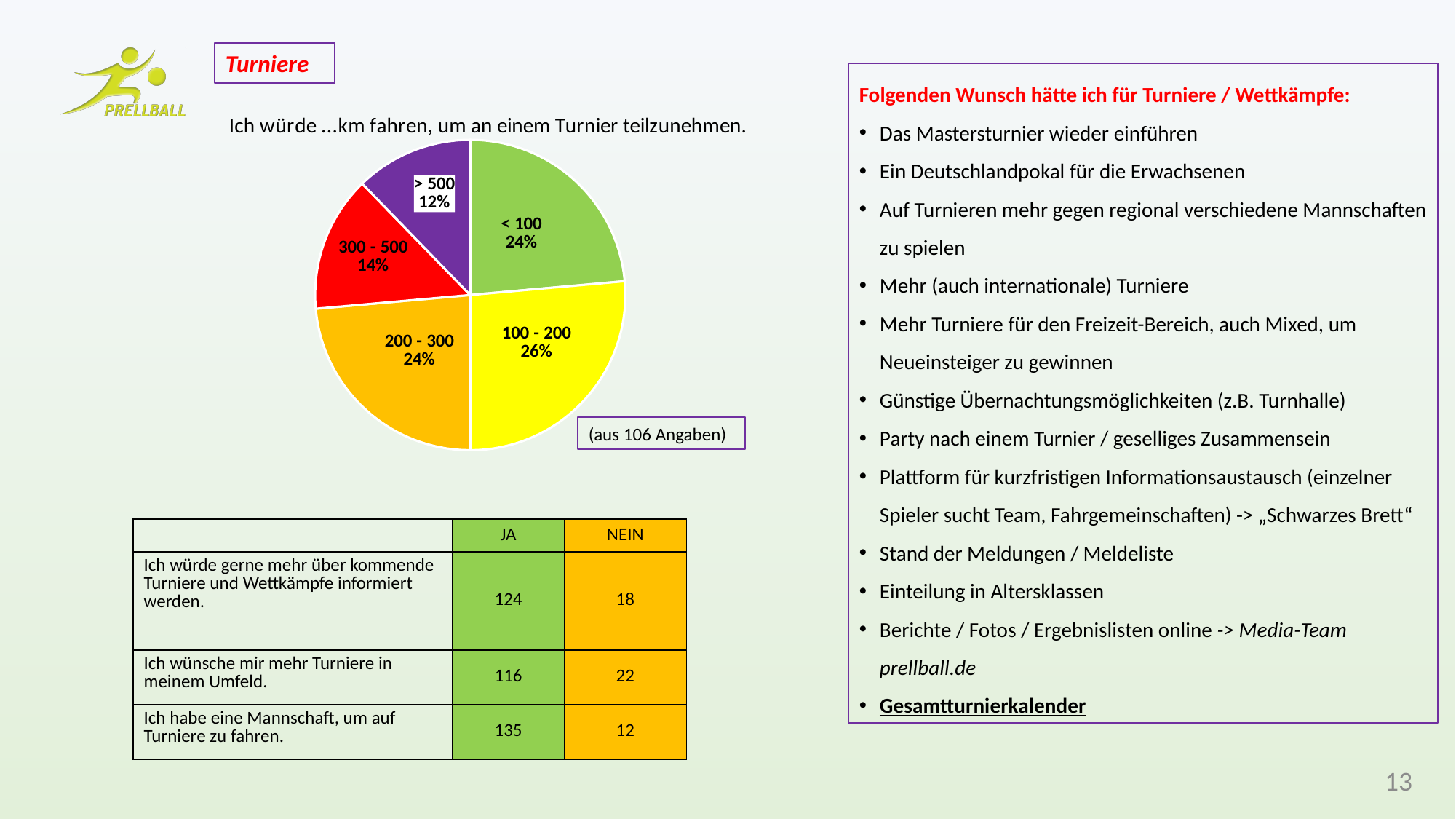
How many responses (Angaben) is the pie chart based on, according to the note next to it? 106 What share of the pie does the "< 100" slice represent? 24% How many slices does the pie chart have? 5 What colour is the "300 - 500" slice of the pie chart? red What share of the pie does the "300 - 500" slice represent? 14% What kind of chart is shown on the slide? pie chart What is the difference in percentage points between the "100 - 200" slice and the "> 500" slice? 14 Which category has the largest share of the pie? 100 - 200 What share of the pie does the "100 - 200" slice represent? 26% Which category has the smallest share of the pie? > 500 Which slice is larger, "300 - 500" or "200 - 300"? 200 - 300